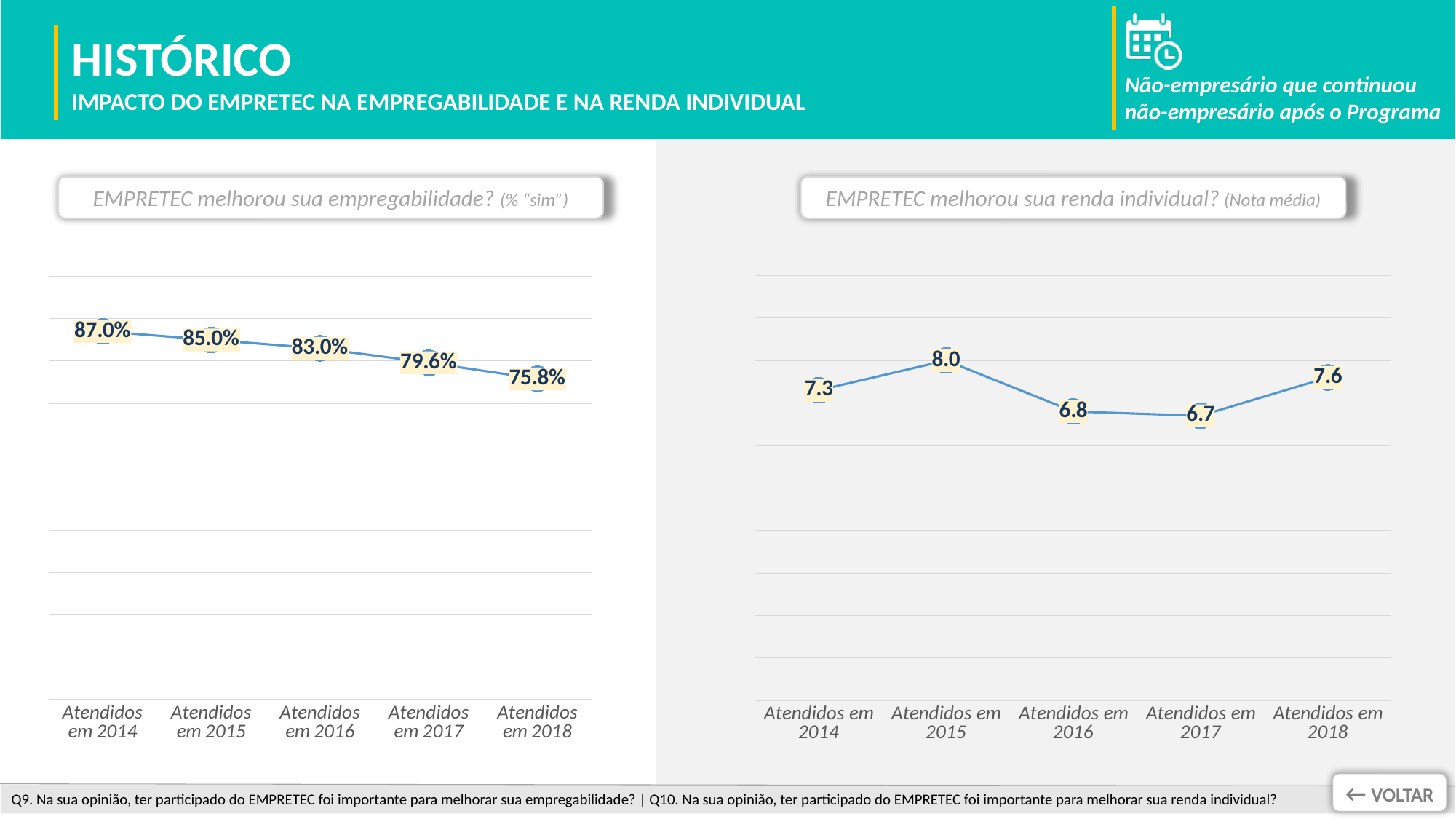
In the right chart (EMPRETEC melhorou sua renda individual?), what is the difference between the values for Atendidos em 2015 and Atendidos em 2016? 1.2 In the left chart (EMPRETEC melhorou sua empregabilidade?), how many data points are plotted? 5 In the left chart (EMPRETEC melhorou sua empregabilidade?), do the values rise or fall from 2014 to 2018? fall In the left chart (EMPRETEC melhorou sua empregabilidade?), which category has the lowest value? Atendidos em 2018 What type of chart is the right chart (EMPRETEC melhorou sua renda individual?)? line chart In the right chart (EMPRETEC melhorou sua renda individual?), what is the value for Atendidos em 2017? 6.7 In the left chart (EMPRETEC melhorou sua empregabilidade?), what is the value for Atendidos em 2018? 75.8% In the right chart (EMPRETEC melhorou sua renda individual?), which category has the highest value? Atendidos em 2015 In the right chart (EMPRETEC melhorou sua renda individual?), what is the value for Atendidos em 2015? 8.0 In the left chart (EMPRETEC melhorou sua empregabilidade?), what is the difference between the values for Atendidos em 2014 and Atendidos em 2018? 11.2% In the left chart (EMPRETEC melhorou sua empregabilidade?), what is the value for Atendidos em 2014? 87.0% In the right chart (EMPRETEC melhorou sua renda individual?), which is larger: the value for Atendidos em 2014 or Atendidos em 2018? Atendidos em 2018